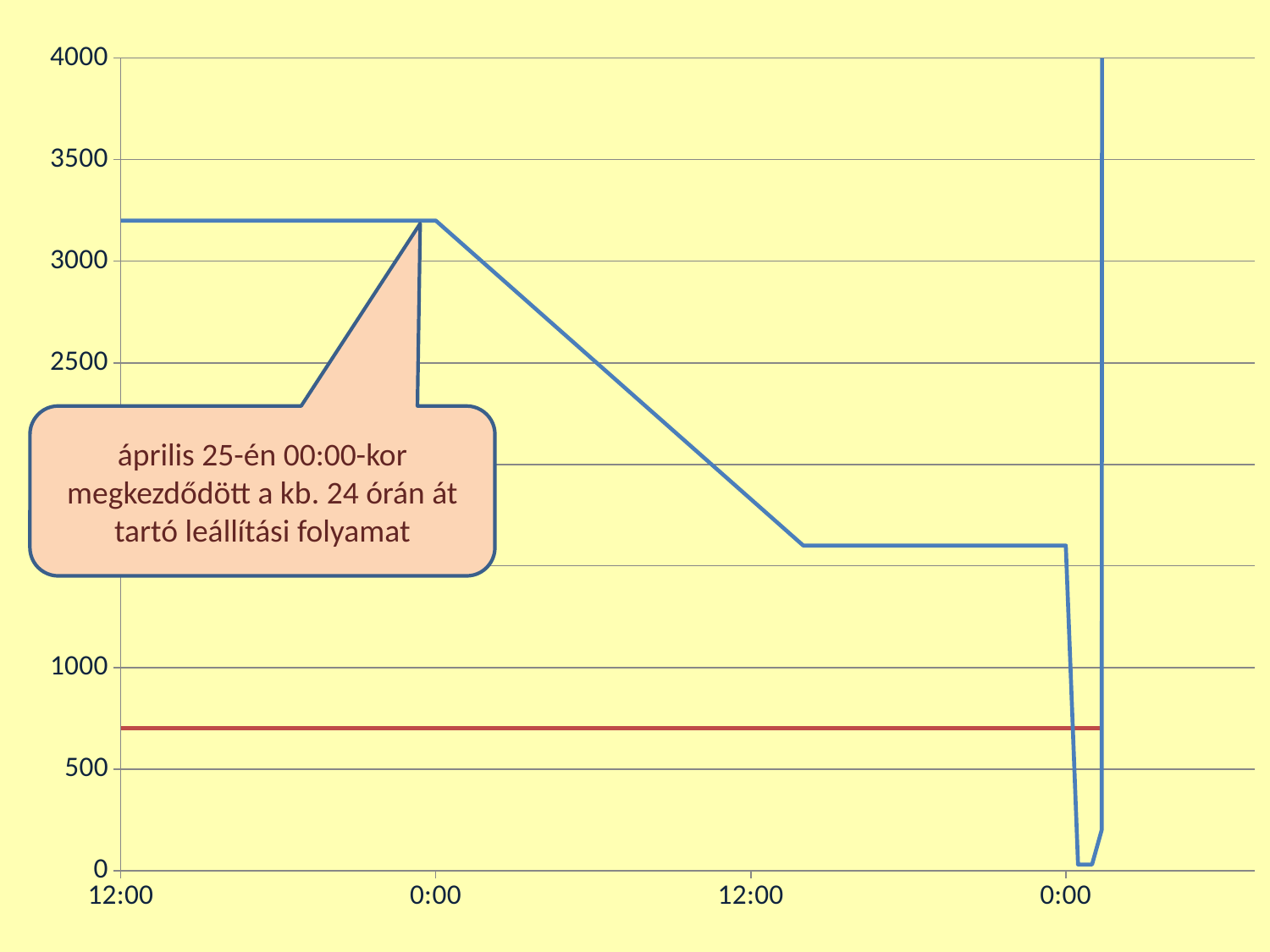
According to the callout, when did the shutdown process begin? április 25-én 00:00-kor Is the value of the blue line at the first 0:00 label greater or less than 3000? greater Is the value of the blue line at the second 12:00 label greater or less than 2500? less At the first 12:00 label, which is higher: the blue line or the red line? the blue line Is the value of the red horizontal line greater or less than 500? greater What kind of chart is shown on the slide? line chart How many time labels are shown on the x axis? 4 What is the highest value shown on the y axis? 4000 Between the first 12:00 label and the first 0:00 label, does the blue line rise, fall or stay flat? stay flat Between the first 0:00 label and the second 12:00 label, does the blue line rise or fall? fall